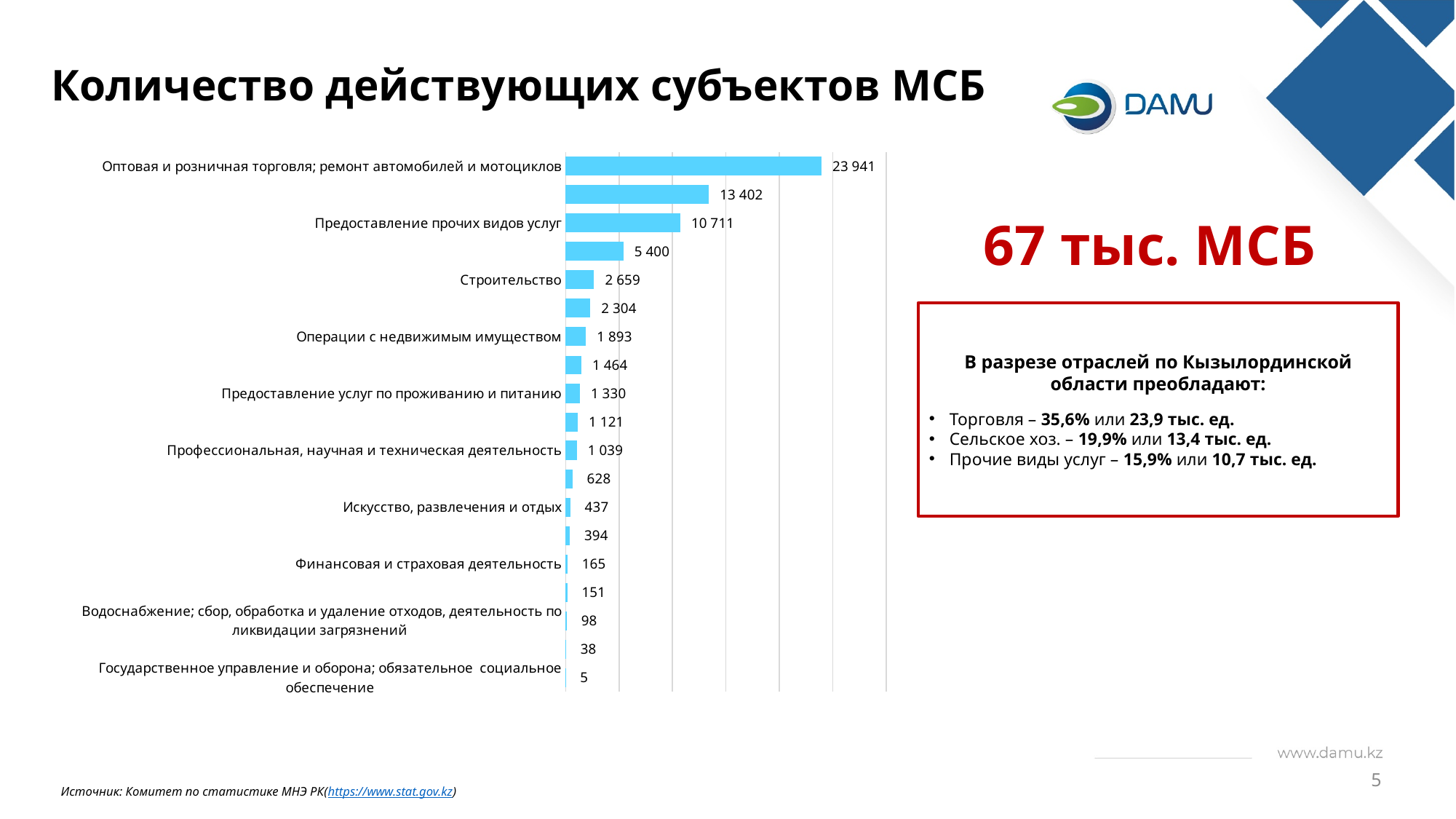
What type of chart is shown on the slide? Bar chart Which category has the lowest value? Государственное управление и оборона; обязательное социальное обеспечение What is the value for "Предоставление прочих видов услуг"? 10 711 Which is larger: the value for "Искусство, развлечения и отдых" or for "Предоставление услуг по проживанию и питанию"? Предоставление услуг по проживанию и питанию What is the value for "Операции с недвижимым имуществом"? 1 893 What is the value for "Финансовая и страховая деятельность"? 165 What is the value for "Строительство"? 2 659 How many bars are plotted in the chart? 19 Which category has the highest value? Оптовая и розничная торговля; ремонт автомобилей и мотоциклов What is the title of the slide containing the chart? Количество действующих субъектов МСБ What is the value for "Оптовая и розничная торговля; ремонт автомобилей и мотоциклов"? 23 941 What is the difference between the values for "Оптовая и розничная торговля; ремонт автомобилей и мотоциклов" and "Предоставление прочих видов услуг"? 13 230